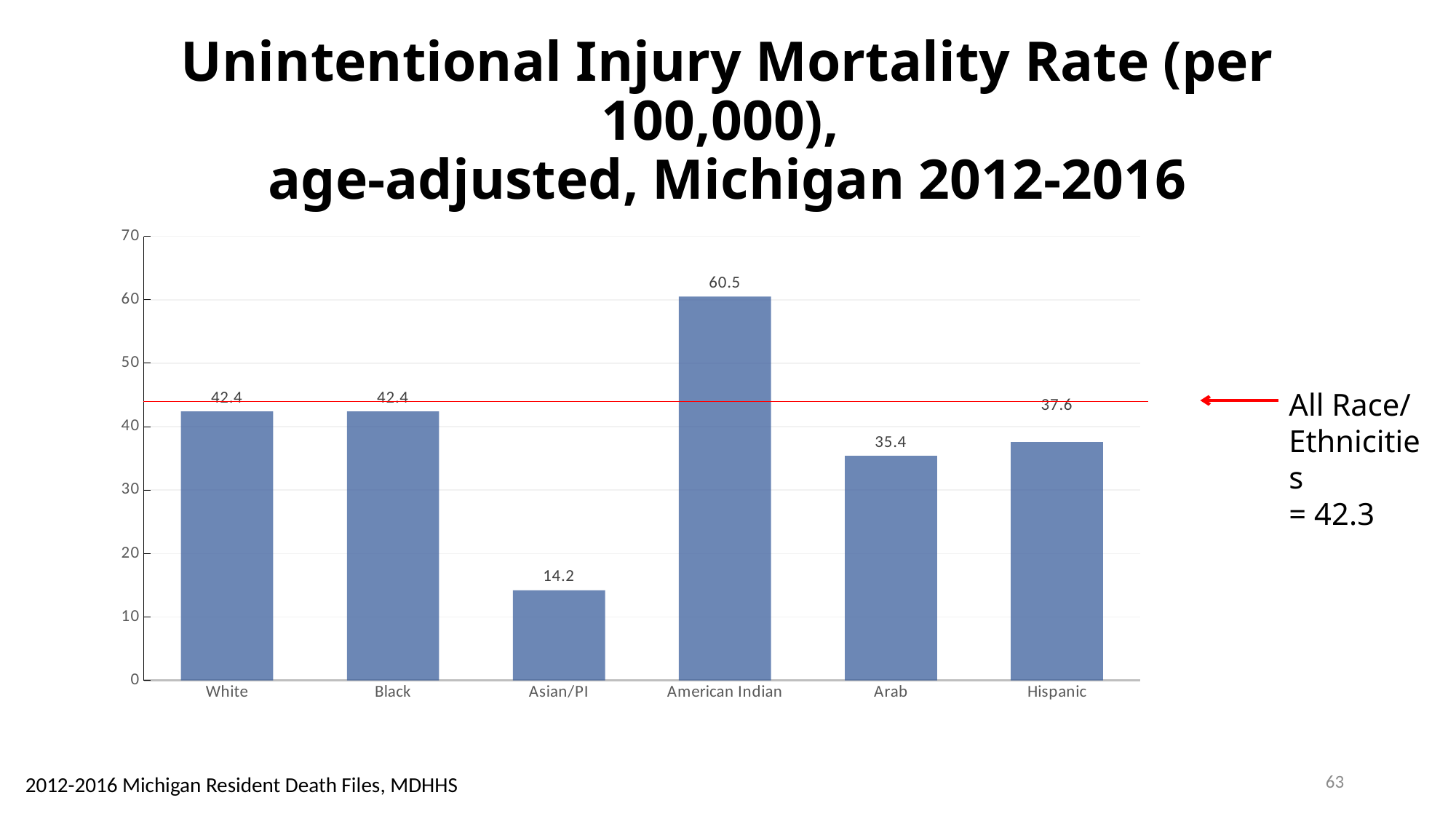
Which race/ethnicity group has the highest unintentional injury mortality rate? American Indian Which race/ethnicity group has the lowest unintentional injury mortality rate? Asian/PI Which group has a higher unintentional injury mortality rate, Hispanic or Arab? Hispanic What is the unintentional injury mortality rate for all races/ethnicities combined, as indicated by the horizontal reference line? 42.3 What type of chart is shown on the slide? Bar chart What is the unintentional injury mortality rate for American Indian residents? 60.5 What is the difference between the unintentional injury mortality rates for American Indian and Asian/PI residents? 46.3 What is the unintentional injury mortality rate for Hispanic residents? 37.6 What is the difference between the unintentional injury mortality rates for Hispanic and Arab residents? 2.2 What is the unintentional injury mortality rate for Arab residents? 35.4 How many race/ethnicity categories are shown on the chart? 6 What is the unintentional injury mortality rate for Asian/PI residents? 14.2